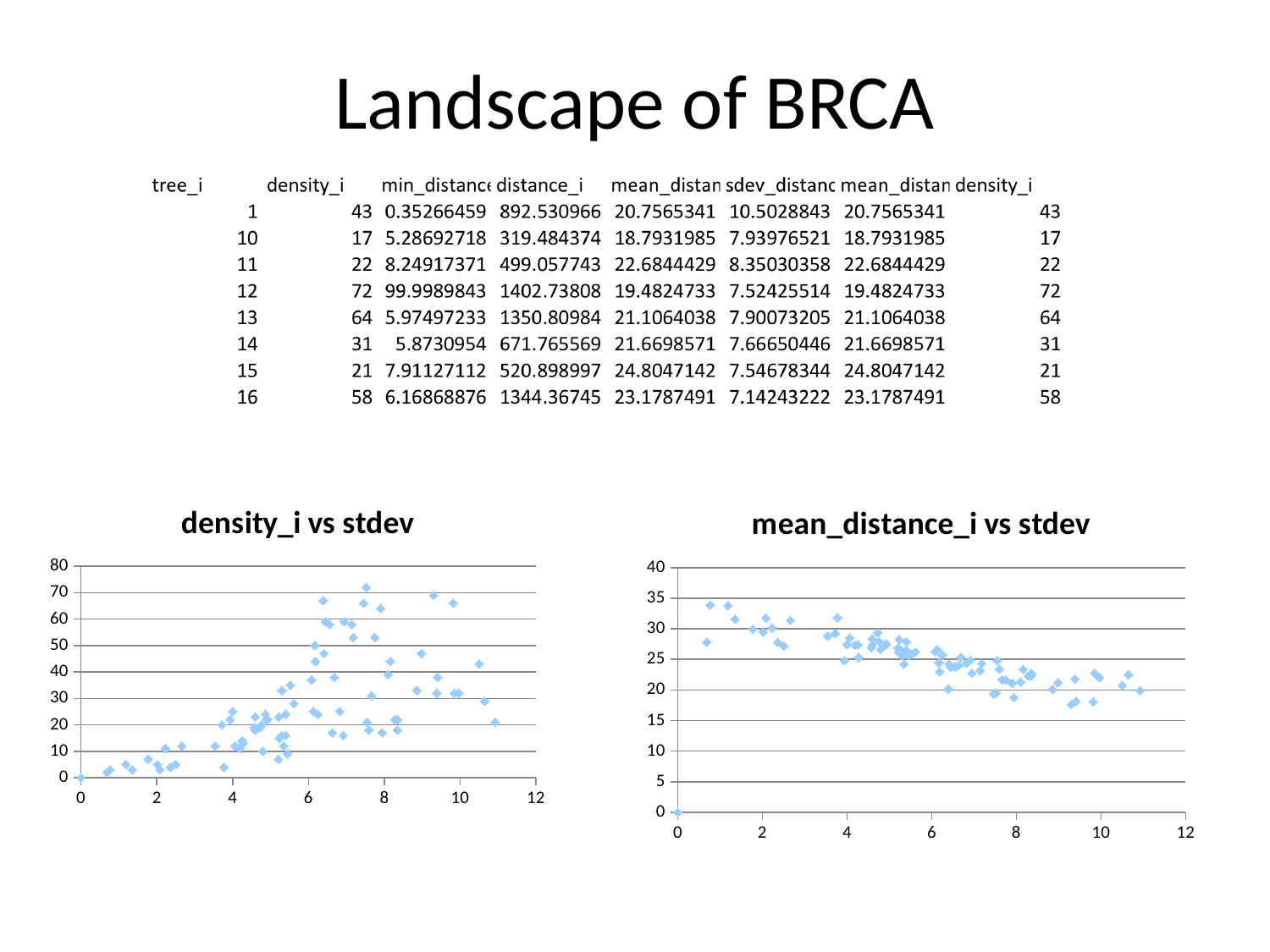
In the "mean_distance_i vs stdev" chart, are the points at x greater than 10 greater or less than 25? less What is the title of the chart on the left of the slide? density_i vs stdev What is the title of the chart on the right of the slide? mean_distance_i vs stdev What kind of chart is the "mean_distance_i vs stdev" chart? scatter chart In the "density_i vs stdev" chart, what is the y value of the point at x = 0? 0 In the "mean_distance_i vs stdev" chart, is the highest point greater or less than 30? greater In the "density_i vs stdev" chart, do the values generally rise or fall as x increases? rise In the "mean_distance_i vs stdev" chart, do the values generally rise or fall as x increases? fall What kind of chart is the "density_i vs stdev" chart? scatter chart In the "mean_distance_i vs stdev" chart, what is the y value of the point at x = 0? 0 In the "density_i vs stdev" chart, is the highest point greater or less than 60? greater